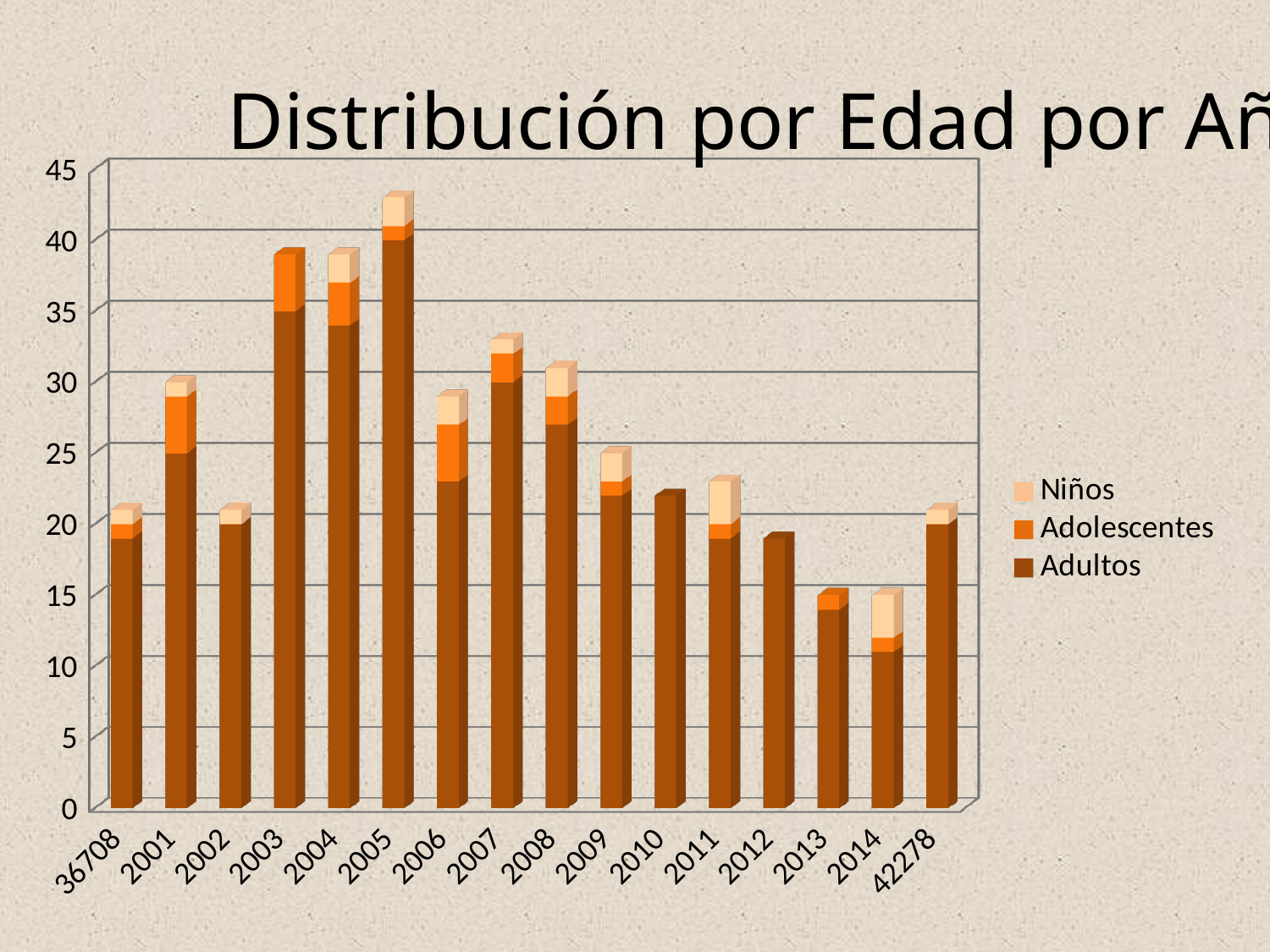
How many categories are shown along the x axis? 16 Which has the larger total bar, 2003 or 2006? 2003 From 2005 to 2013, do the total bar heights generally rise or fall? fall Is the total for 2005 greater or less than 40? greater What kind of chart is shown on the slide? Stacked bar chart What are the three series named in the legend? Niños, Adolescentes, Adultos How many series does the legend list? 3 Is the total for 2014 greater or less than 20? less Is the total for 2013 greater or less than 20? less Which category has the highest total bar? 2005 Which has the larger total bar, 2001 or 2002? 2001